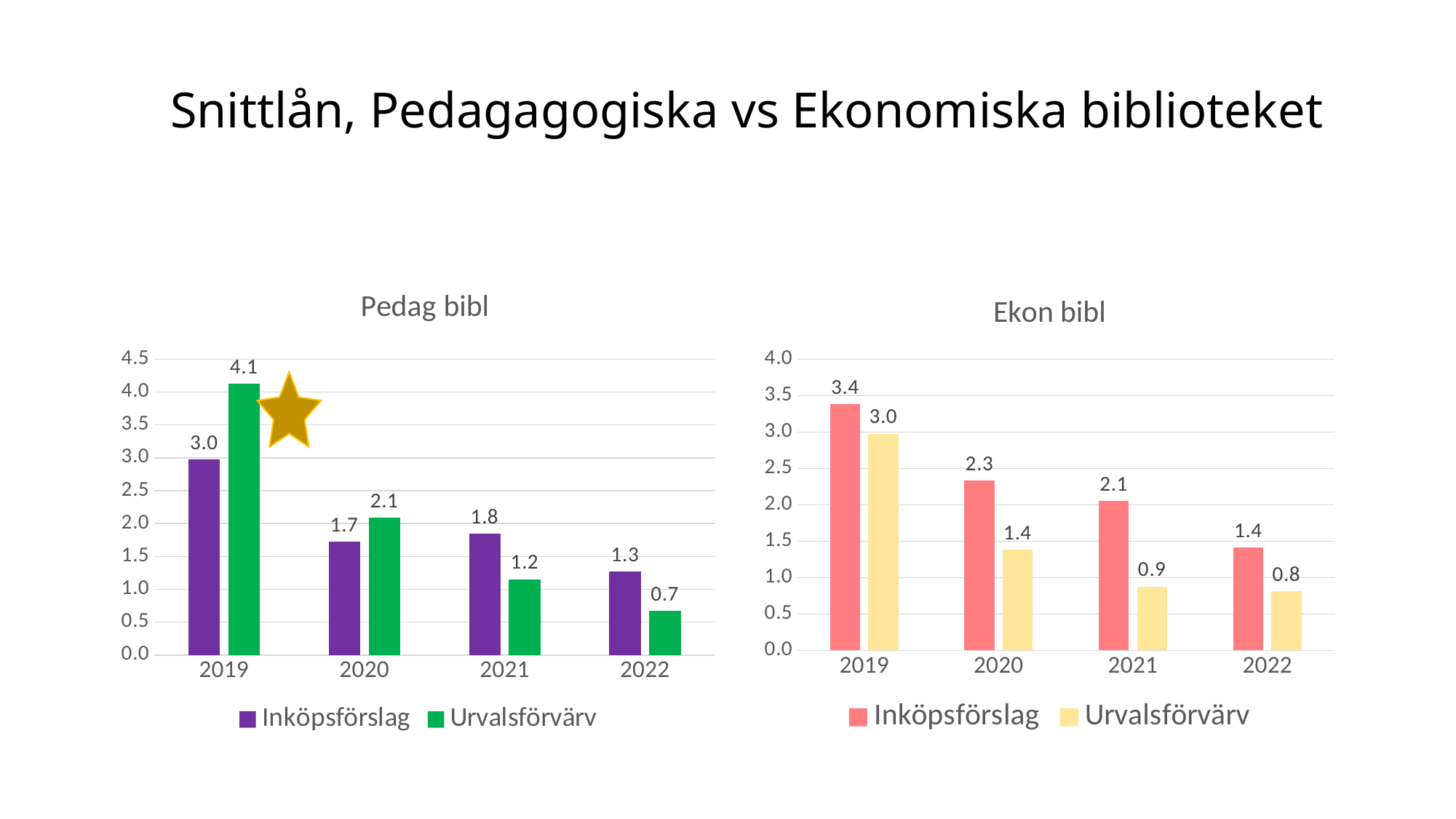
In the 'Ekon bibl' chart, what is the value for Inköpsförslag in 2020? 2.3 In the 'Pedag bibl' chart, which year has the highest Inköpsförslag value? 2019 In the 'Ekon bibl' chart, what is the difference between Inköpsförslag and Urvalsförvärv in 2021? 1.2 How many years are shown on the x axis of the 'Ekon bibl' chart? 4 How many series does the legend of the 'Pedag bibl' chart list? 2 In the 'Ekon bibl' chart, do the Inköpsförslag values rise or fall from 2019 to 2022? Fall In the 'Ekon bibl' chart, which year has the lowest Urvalsförvärv value? 2022 In the 'Ekon bibl' chart, is the value for Inköpsförslag in 2019 greater or less than 3.0? greater In the 'Pedag bibl' chart, which is larger in 2021, Inköpsförslag or Urvalsförvärv? Inköpsförslag What kind of chart is the 'Ekon bibl' chart? Bar chart In the 'Pedag bibl' chart, what is the value for Urvalsförvärv in 2019? 4.1 In the 'Pedag bibl' chart, what is the difference between Urvalsförvärv and Inköpsförslag in 2019? 1.1